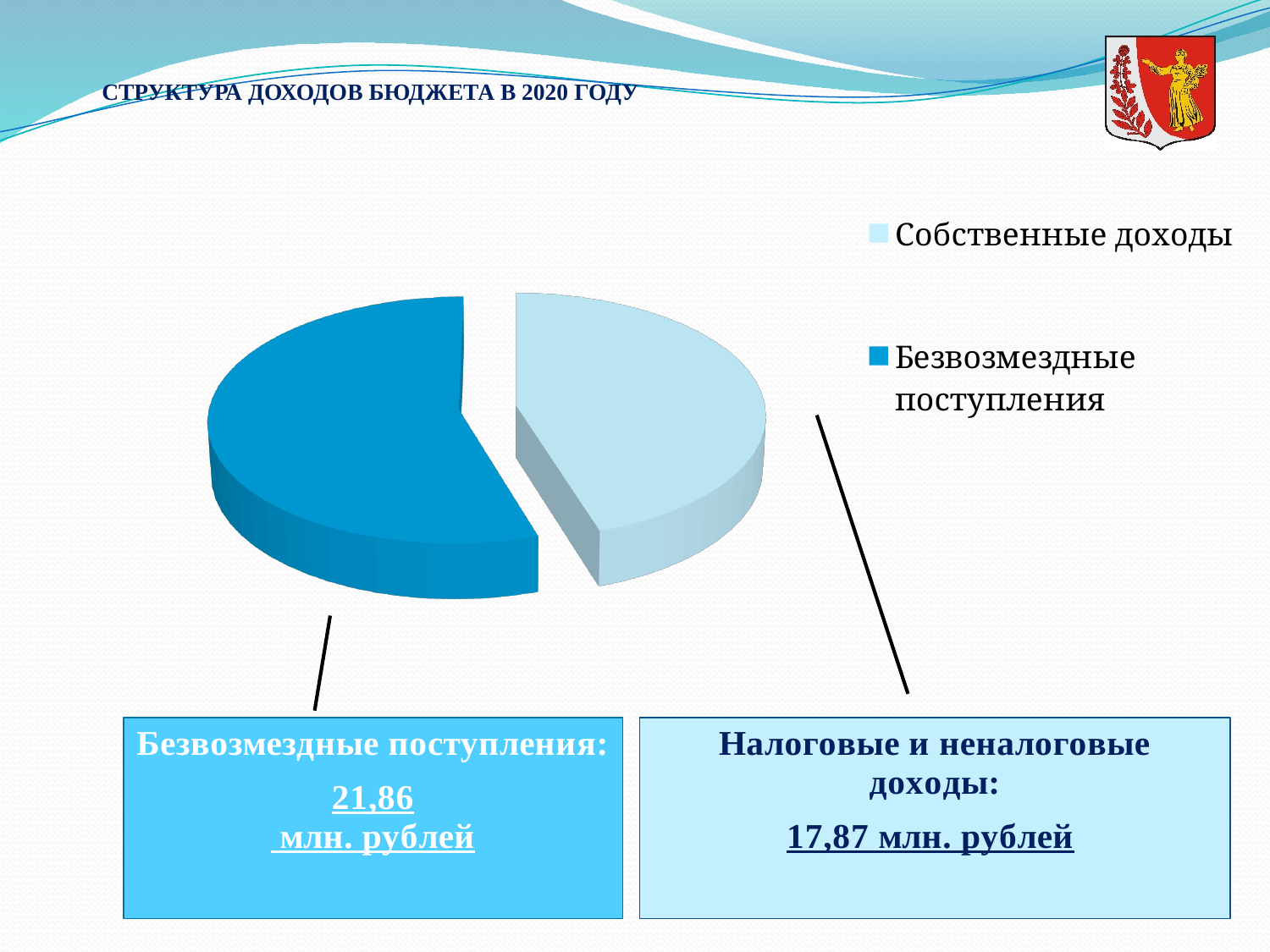
Which category has the smallest slice in the pie chart? Собственные доходы What is the difference between Безвозмездные поступления (21,86 млн. рублей) and Налоговые и неналоговые доходы (17,87 млн. рублей)? 3,99 млн. рублей What is the total of the two values shown on the slide, 21,86 and 17,87 млн. рублей? 39,73 млн. рублей What kind of chart is shown on the slide? pie chart How many slices does the pie chart have? 2 What is the title of the slide containing the pie chart? СТРУКТУРА ДОХОДОВ БЮДЖЕТА В 2020 ГОДУ Which slice of the pie chart is larger: Безвозмездные поступления or Собственные доходы? Безвозмездные поступления What is the value shown for Налоговые и неналоговые доходы? 17,87 млн. рублей Which legend entry is shown in the darker blue colour? Безвозмездные поступления Which category has the largest slice in the pie chart? Безвозмездные поступления How many entries does the legend of the pie chart list? 2 What is the value shown for Безвозмездные поступления? 21,86 млн. рублей